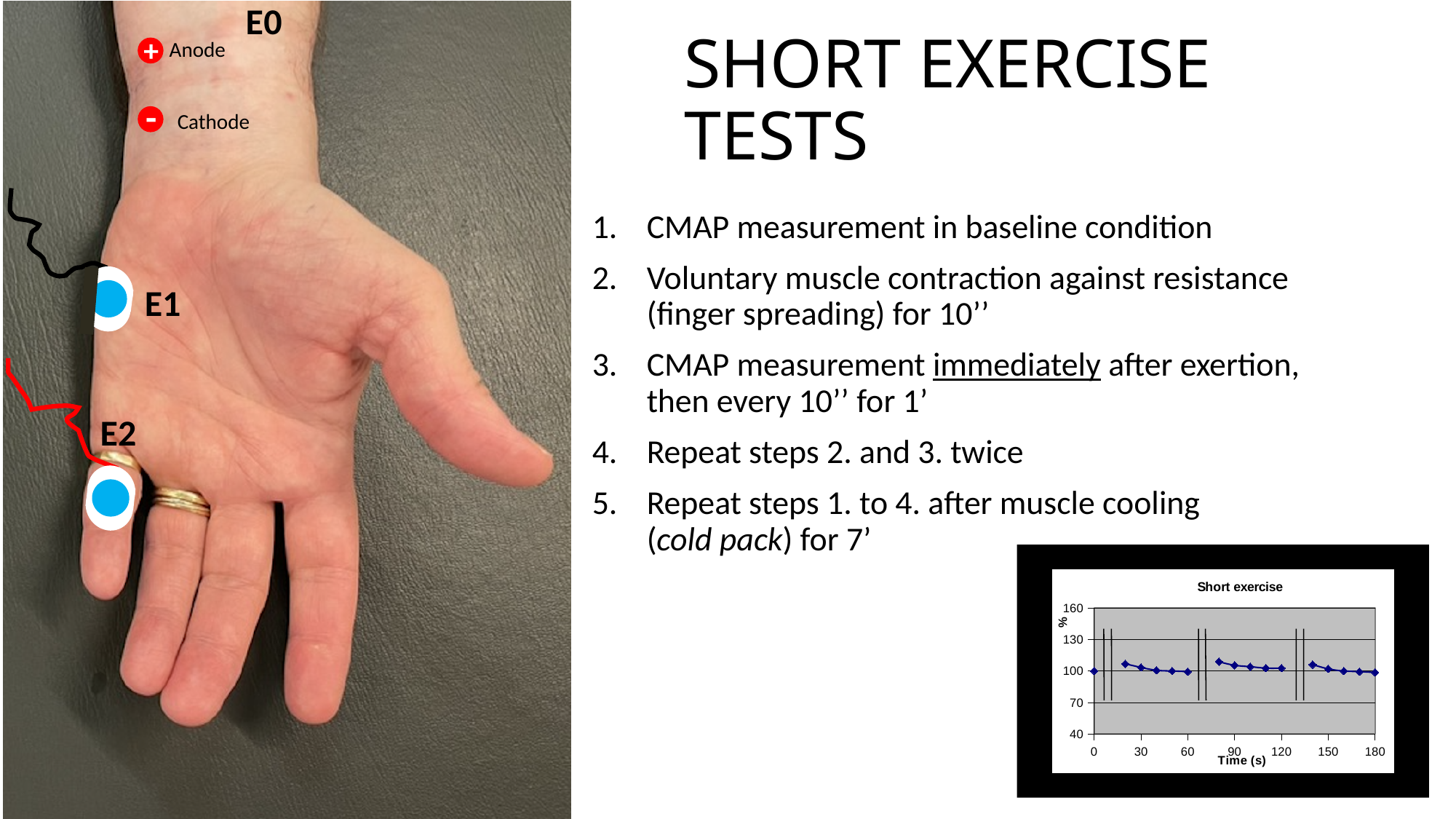
What is the highest value shown on the y axis of the 'Short exercise' chart? 160 In the 'Short exercise' chart, do the values rise or fall between 80 s and 120 s? fall What kind of chart is the 'Short exercise' chart? line chart In the 'Short exercise' chart, is the value at 140 s greater or less than 100? greater What is the label of the x axis of the 'Short exercise' chart? Time (s) In the 'Short exercise' chart, is the value at 180 s greater or less than 130? less In the 'Short exercise' chart, is the value at 20 s larger or smaller than the value at 60 s? larger In the 'Short exercise' chart, do the values rise or fall between 20 s and 60 s? fall In the 'Short exercise' chart, is the value at 80 s greater or less than 130? less In the 'Short exercise' chart, do the values rise or fall between 140 s and 180 s? fall What is the title of the chart on the slide? Short exercise